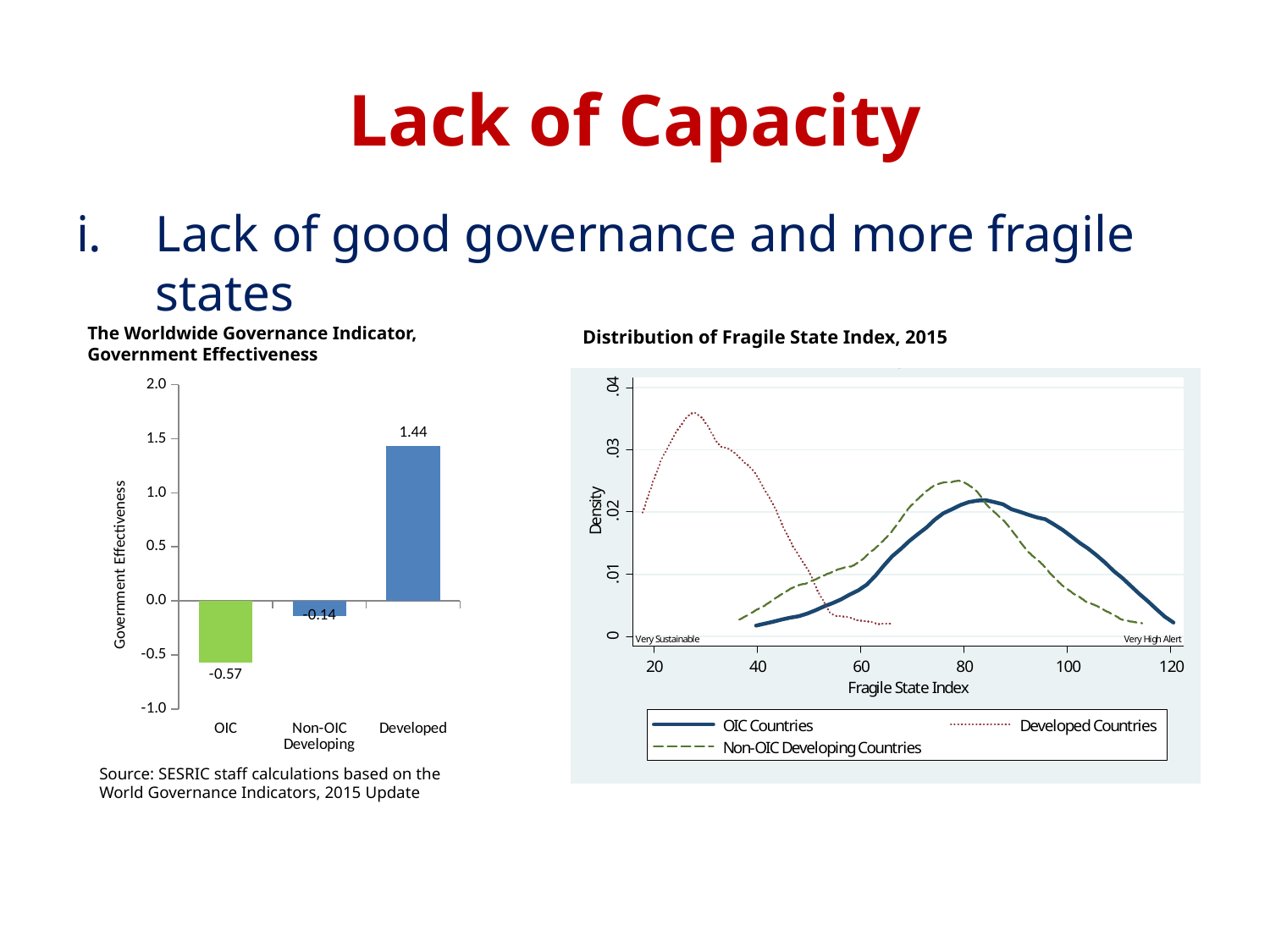
What kind of chart is 'The Worldwide Governance Indicator, Government Effectiveness'? Bar chart In the chart titled 'Distribution of Fragile State Index, 2015', what is the label on the y axis? Density In the chart titled 'The Worldwide Governance Indicator, Government Effectiveness', what is the value for Developed? 1.44 In the chart titled 'The Worldwide Governance Indicator, Government Effectiveness', which category has the highest value? Developed In the chart titled 'Distribution of Fragile State Index, 2015', which series is drawn with a dotted line? Developed Countries In the chart titled 'The Worldwide Governance Indicator, Government Effectiveness', what is the difference between the Developed value and the OIC value? 2.01 In the chart titled 'The Worldwide Governance Indicator, Government Effectiveness', which category has the lowest value? OIC In the chart titled 'The Worldwide Governance Indicator, Government Effectiveness', what is the value for OIC? -0.57 In the chart titled 'The Worldwide Governance Indicator, Government Effectiveness', which is larger, the value for OIC or the value for Non-OIC Developing? Non-OIC Developing In the chart titled 'The Worldwide Governance Indicator, Government Effectiveness', what is the value for Non-OIC Developing? -0.14 In the chart titled 'The Worldwide Governance Indicator, Government Effectiveness', how many categories are shown? 3 In the chart titled 'Distribution of Fragile State Index, 2015', how many series does the legend list? 3